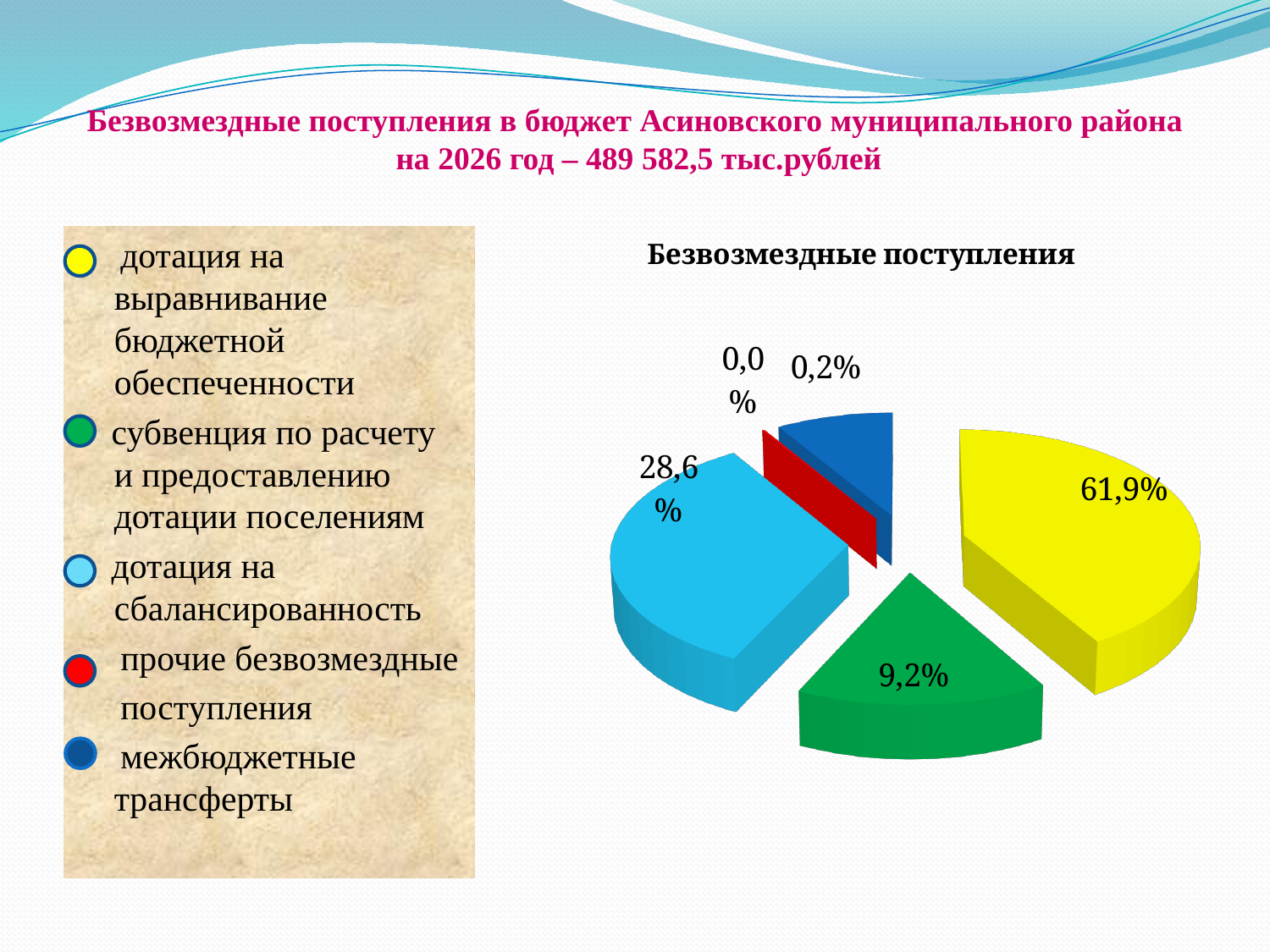
What is the difference in percentage points between the yellow slice (61,9%) and the light blue slice (28,6%)? 33,3 What share of the pie is the red slice (прочие безвозмездные поступления)? 0,0% Which category has the largest share of the pie? дотация на выравнивание бюджетной обеспеченности Which category has the smallest share of the pie? прочие безвозмездные поступления How many slices does the pie chart have? 5 What share of the pie is the light blue slice (дотация на сбалансированность)? 28,6% What share of the pie is the yellow slice (дотация на выравнивание бюджетной обеспеченности)? 61,9% What is the title of the pie chart? Безвозмездные поступления What type of chart is shown on the slide? pie chart Which is larger: the share for дотация на сбалансированность or the share for субвенция по расчету и предоставлению дотации поселениям? дотация на сбалансированность